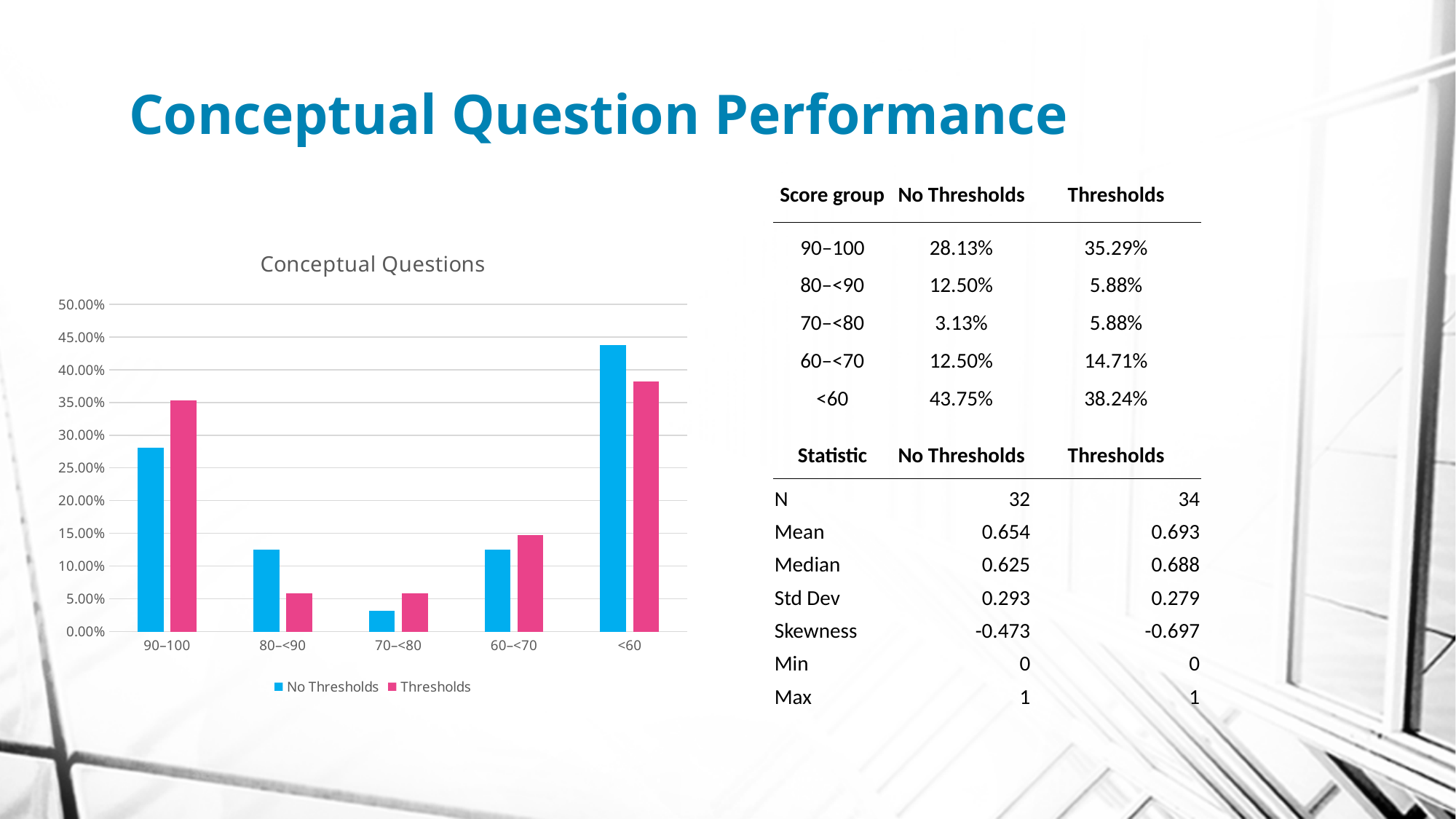
How many series does the chart legend list? 2 What is the No Thresholds value for the <60 score group, as printed in the table on the slide? 43.75% Which score group has the highest No Thresholds value? <60 Is the Thresholds value for the 90–100 score group greater or less than 30.00%? greater For the 80–<90 score group, which series has the larger value, No Thresholds or Thresholds? No Thresholds Which score group has the highest Thresholds value? <60 How many score group categories are shown on the x axis of the chart? 5 Which score group has the lowest No Thresholds value? 70–<80 What kind of chart is shown on the slide? bar chart Is the No Thresholds value for the <60 score group greater or less than 40.00%? greater What is the title of the chart? Conceptual Questions For the 90–100 score group, which series has the larger value, No Thresholds or Thresholds? Thresholds